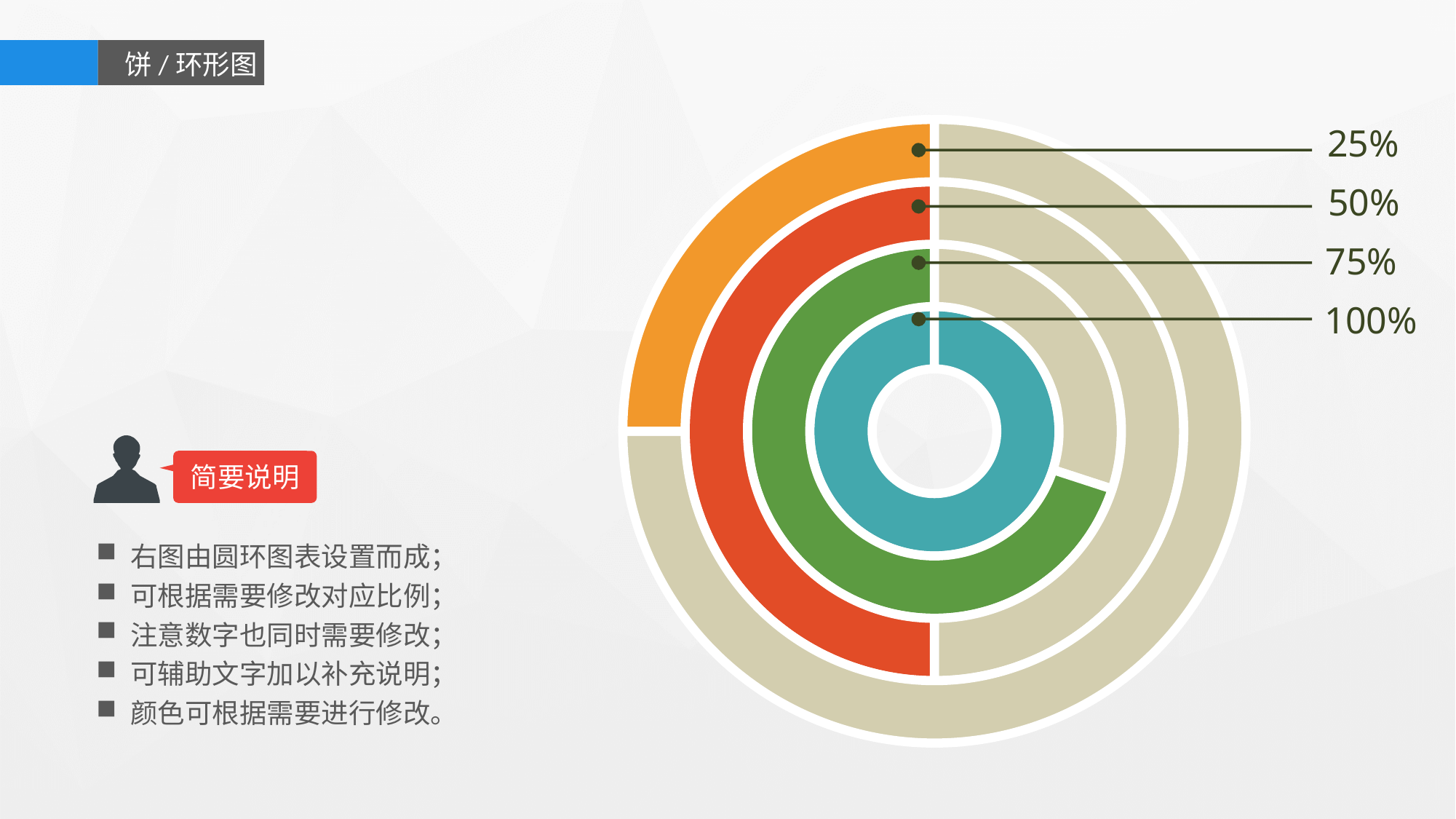
What colour is the ring labelled 100%? Blue What is the difference between the innermost ring's value and the outermost ring's value? 75% What percentage is labelled for the outermost (orange) ring? 25% What percentage is labelled for the green ring? 75% What percentage is labelled for the innermost (blue) ring? 100% Which is larger, the value of the red ring or the value of the green ring? The green ring Do the labelled percentages increase or decrease moving from the outer ring to the inner ring? Increase Which ring has the highest labelled percentage? The innermost (blue) ring What kind of chart is shown on the slide? Doughnut chart How many rings does the doughnut chart have? 4 What percentage is labelled for the red ring? 50% Which ring has the lowest labelled percentage? The outermost (orange) ring